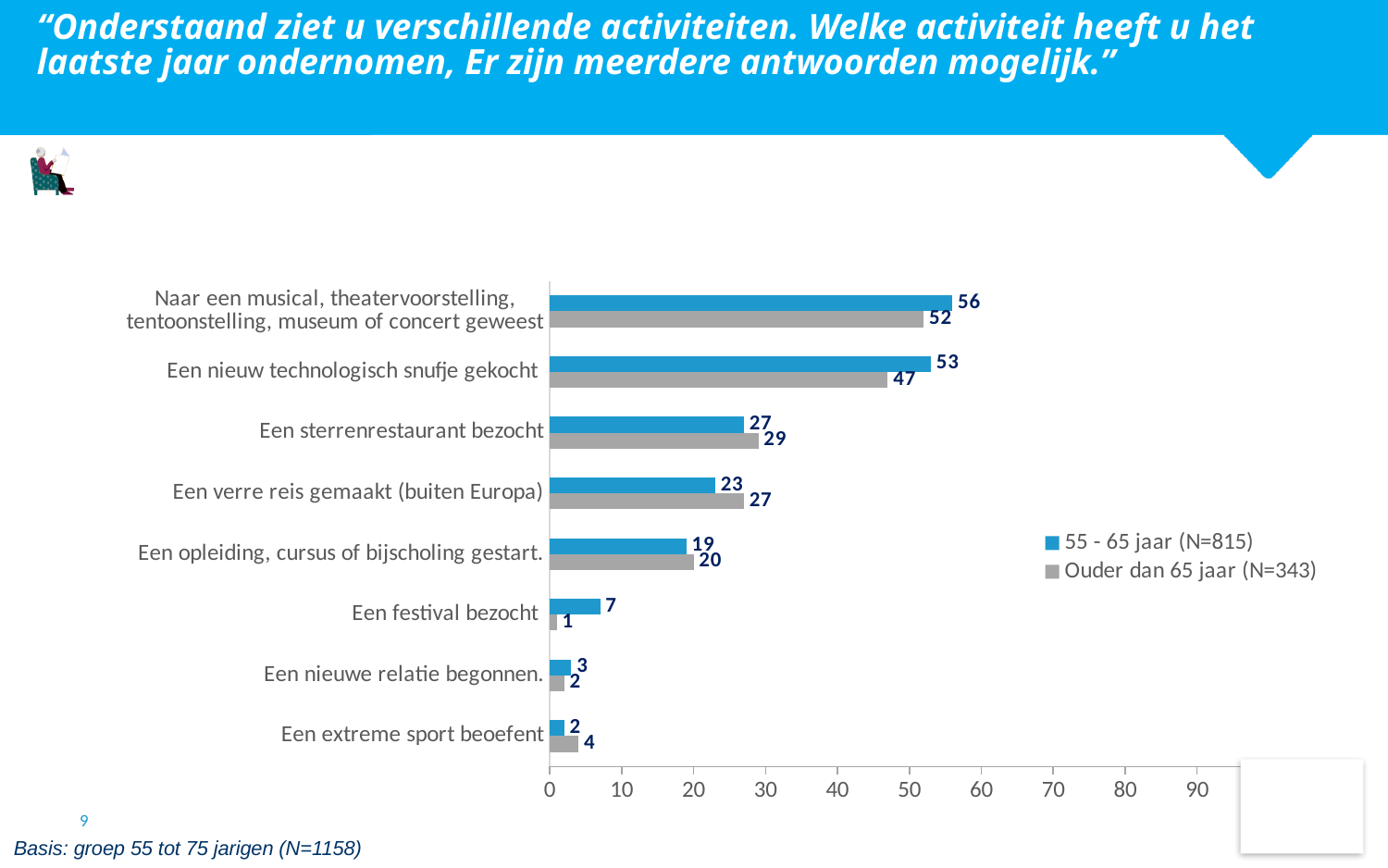
Which category has the highest value in the '55 - 65 jaar (N=815)' series? Naar een musical, theatervoorstelling, tentoonstelling, museum of concert geweest What colour are the bars for the 'Ouder dan 65 jaar (N=343)' series? Grey How many series does the legend list? 2 How many categories are shown on the chart? 8 What is the value for 'Een sterrenrestaurant bezocht' in the 'Ouder dan 65 jaar (N=343)' series? 29 Is the value for 'Naar een musical, theatervoorstelling, tentoonstelling, museum of concert geweest' in the '55 - 65 jaar (N=815)' series greater or less than 50? greater For 'Een verre reis gemaakt (buiten Europa)', which series has the larger value? Ouder dan 65 jaar (N=343) What is the difference between the '55 - 65 jaar (N=815)' and 'Ouder dan 65 jaar (N=343)' values for 'Een nieuw technologisch snufje gekocht'? 6 What is the value for 'Een festival bezocht' in the 'Ouder dan 65 jaar (N=343)' series? 1 What is the value for 'Een nieuw technologisch snufje gekocht' in the '55 - 65 jaar (N=815)' series? 53 What kind of chart is shown on the slide? Bar chart Which category has the lowest value in the '55 - 65 jaar (N=815)' series? Een extreme sport beoefent